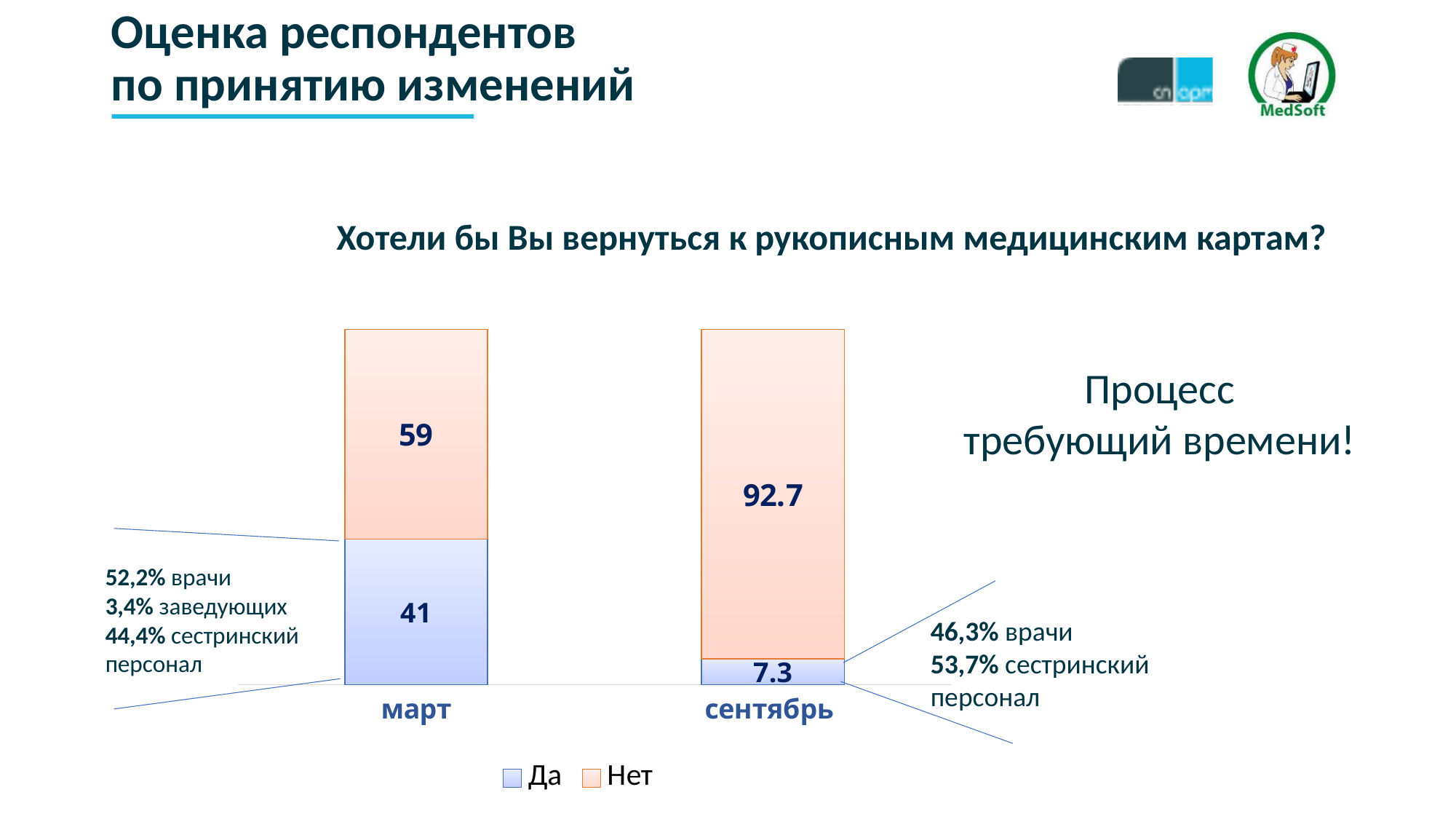
How many series does the chart legend list? 2 What is the value of the "Да" segment for сентябрь? 7.3 What is the value of the "Да" segment for март? 41 Which category has the higher "Да" value, март or сентябрь? март How many categories are shown on the x axis of the chart? 2 What is the total of the stacked bar for сентябрь? 100 What is the value of the "Нет" segment for сентябрь? 92.7 What is the difference between the "Нет" values for сентябрь and март? 33.7 What is the difference between the "Да" and "Нет" values for март? 18 What type of chart is shown on the slide? Stacked bar chart What is the value of the "Нет" segment for март? 59 Which category has the lowest "Да" value? сентябрь